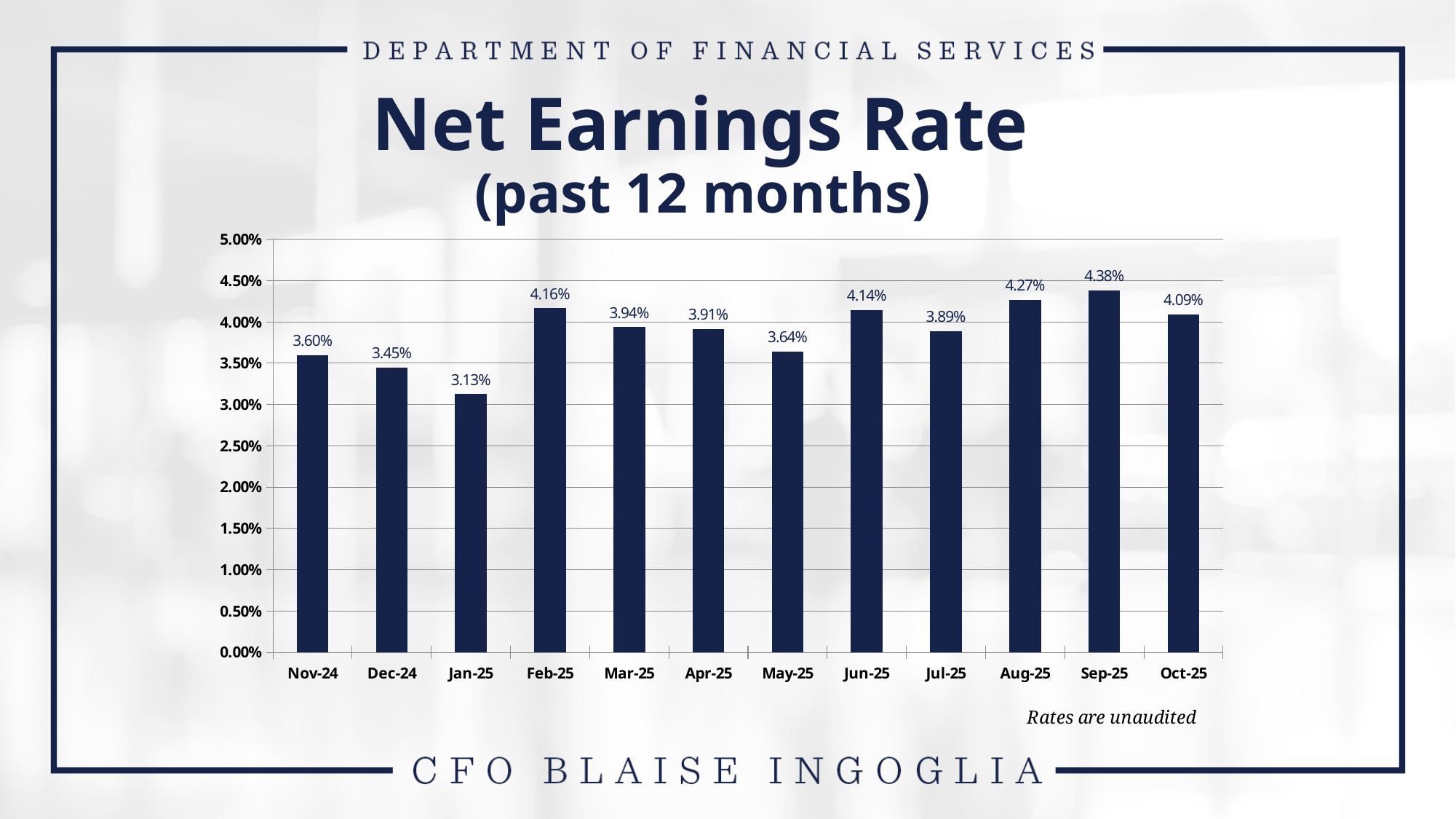
What is the difference between the net earnings rate in Sep-25 and Jan-25? 1.25% Which month has the lowest net earnings rate? Jan-25 What is the net earnings rate for Oct-25? 4.09% Which month has a higher net earnings rate, Nov-24 or Dec-24? Nov-24 What is the net earnings rate for Jan-25? 3.13% What is the net earnings rate for Feb-25? 4.16% What kind of chart is shown on the slide? bar chart Is the net earnings rate for May-25 greater or less than 4.00%? less What is the title of the chart? Net Earnings Rate (past 12 months) How many months are shown on the chart? 12 What is the difference between the net earnings rate in Aug-25 and Jul-25? 0.38% Which month has the highest net earnings rate? Sep-25